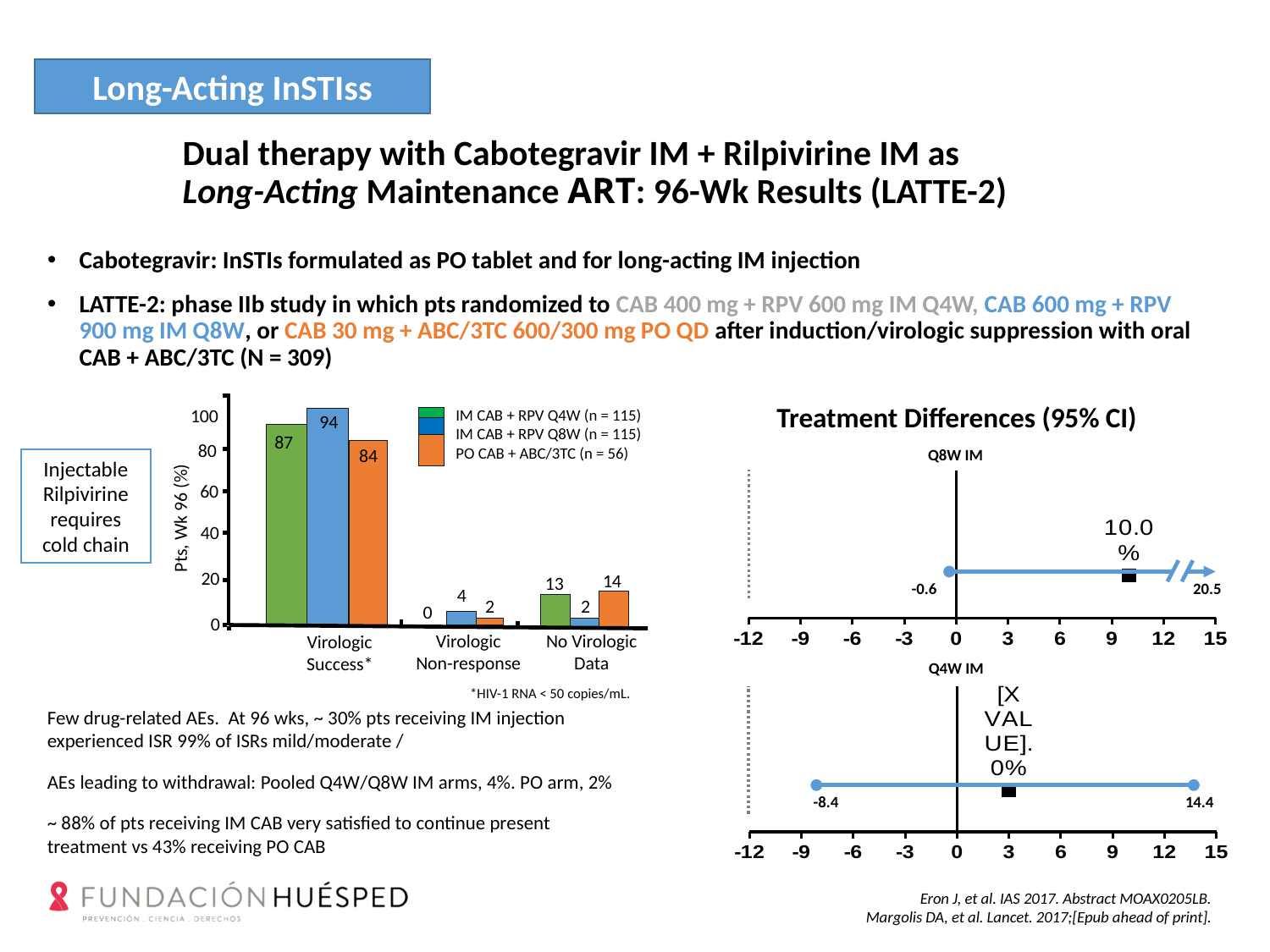
In the bar chart on the left, what is the value for IM CAB + RPV Q8W in the Virologic Success category? 94 In the Treatment Differences (95% CI) chart for Q8W IM, what is the upper bound of the confidence interval? 20.5 In the bar chart on the left, which series has the highest value for Virologic Success? IM CAB + RPV Q8W (n = 115) In the Treatment Differences (95% CI) chart for Q4W IM, what is the lower bound of the confidence interval? -8.4 In the bar chart on the left, how many series does the legend list? 3 In the bar chart on the left, how many categories are shown on the x axis? 3 In the bar chart on the left, which series has the lowest value in the No Virologic Data category? IM CAB + RPV Q8W (n = 115) In the bar chart on the left, what is the value for IM CAB + RPV Q4W in the Virologic Non-response category? 0 What type of chart is shown on the left of the slide? Bar chart In the bar chart on the left, what is the value for PO CAB + ABC/3TC in the No Virologic Data category? 14 In the bar chart on the left, what is the difference between the Virologic Success values for IM CAB + RPV Q8W and PO CAB + ABC/3TC? 10 In the bar chart on the left, which is larger: the No Virologic Data value for IM CAB + RPV Q4W or for PO CAB + ABC/3TC? PO CAB + ABC/3TC